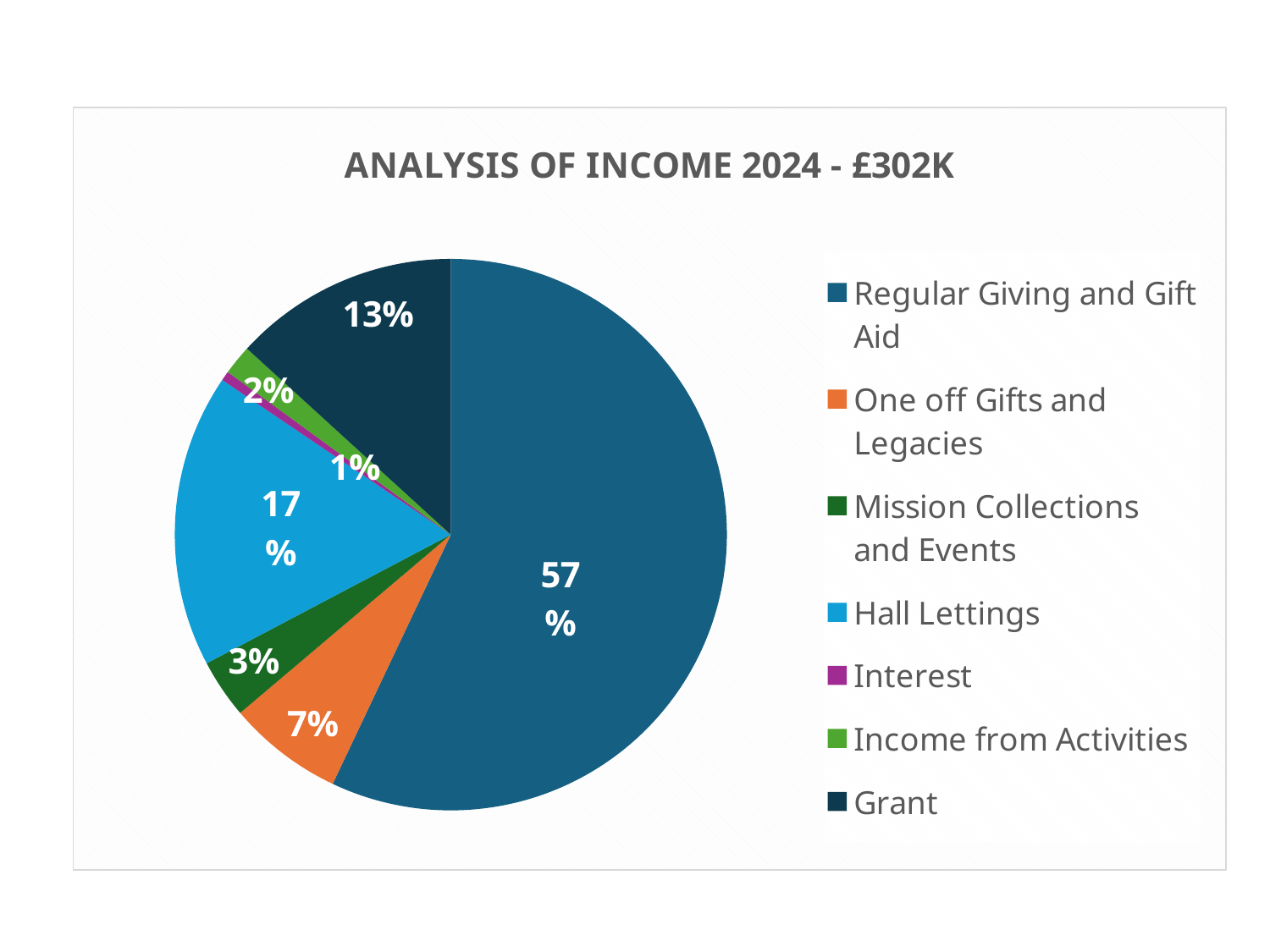
How many categories are shown in the pie chart? 7 Which is larger, the share for Mission Collections and Events or the share for Income from Activities? Mission Collections and Events Which category has the largest share of income? Regular Giving and Gift Aid What share of income does Interest represent? 1% What is the title of the chart? ANALYSIS OF INCOME 2024 - £302K What share of income does Grant represent? 13% What share of income does One off Gifts and Legacies represent? 7% Which category has the smallest share of income? Interest What kind of chart is shown on the slide? Pie chart What is the difference in percentage points between Hall Lettings and Grant? 4